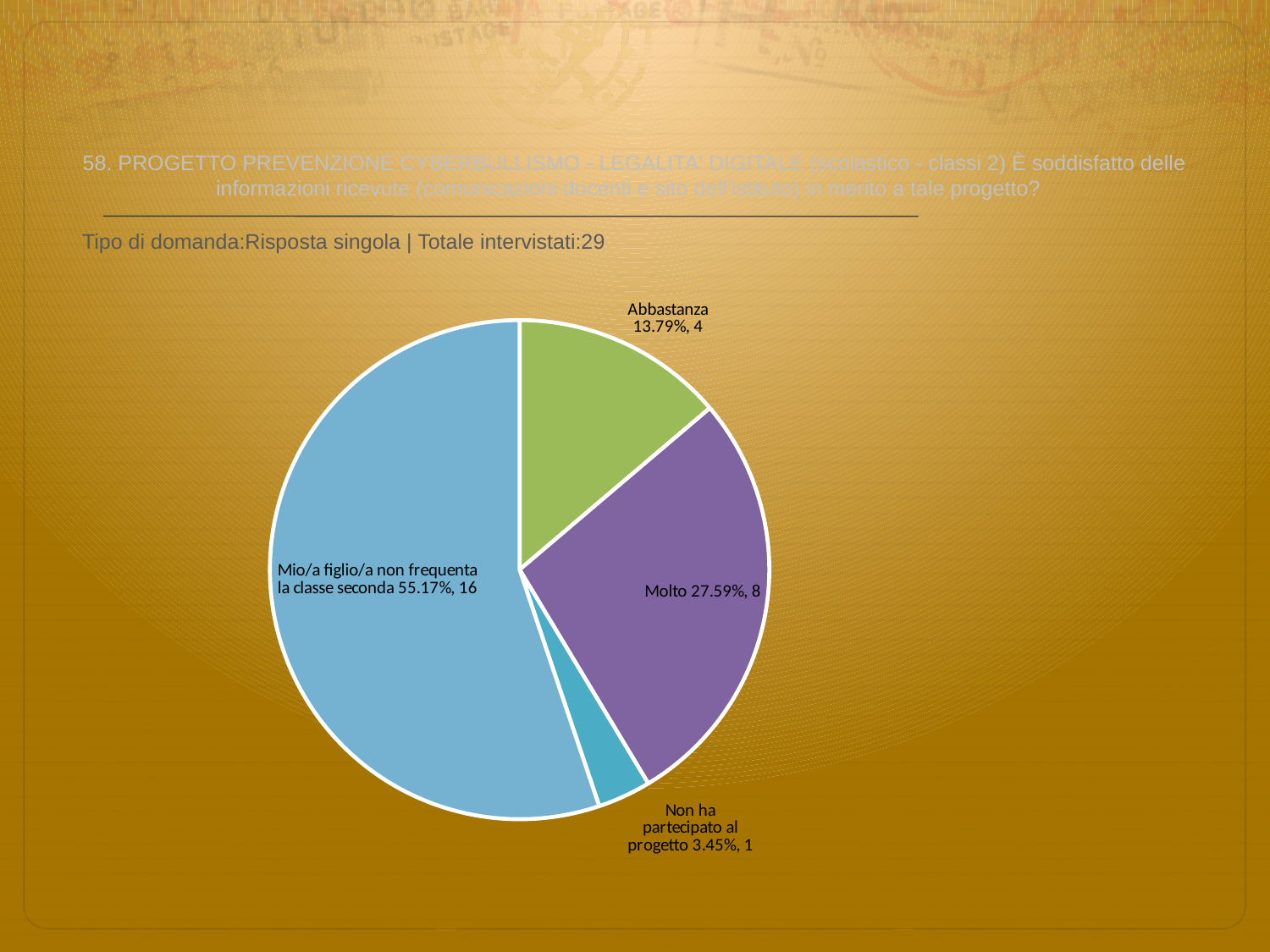
How many respondents chose 'Non ha partecipato al progetto'? 1 Which slice of the pie chart is the smallest? Non ha partecipato al progetto How many slices does the pie chart have? 4 Which slice of the pie chart is the largest? Mio/a figlio/a non frequenta la classe seconda What is the difference in number of respondents between 'Molto' and 'Abbastanza'? 4 What kind of chart is shown on the slide? pie chart What is the total number of respondents shown in the pie chart? 29 How many respondents answered 'Abbastanza'? 4 Which has more respondents, 'Molto' or 'Abbastanza'? Molto What percentage is shown for the 'Molto' slice? 27.59% What colour is the 'Molto' slice? purple What percentage is shown for 'Mio/a figlio/a non frequenta la classe seconda'? 55.17%